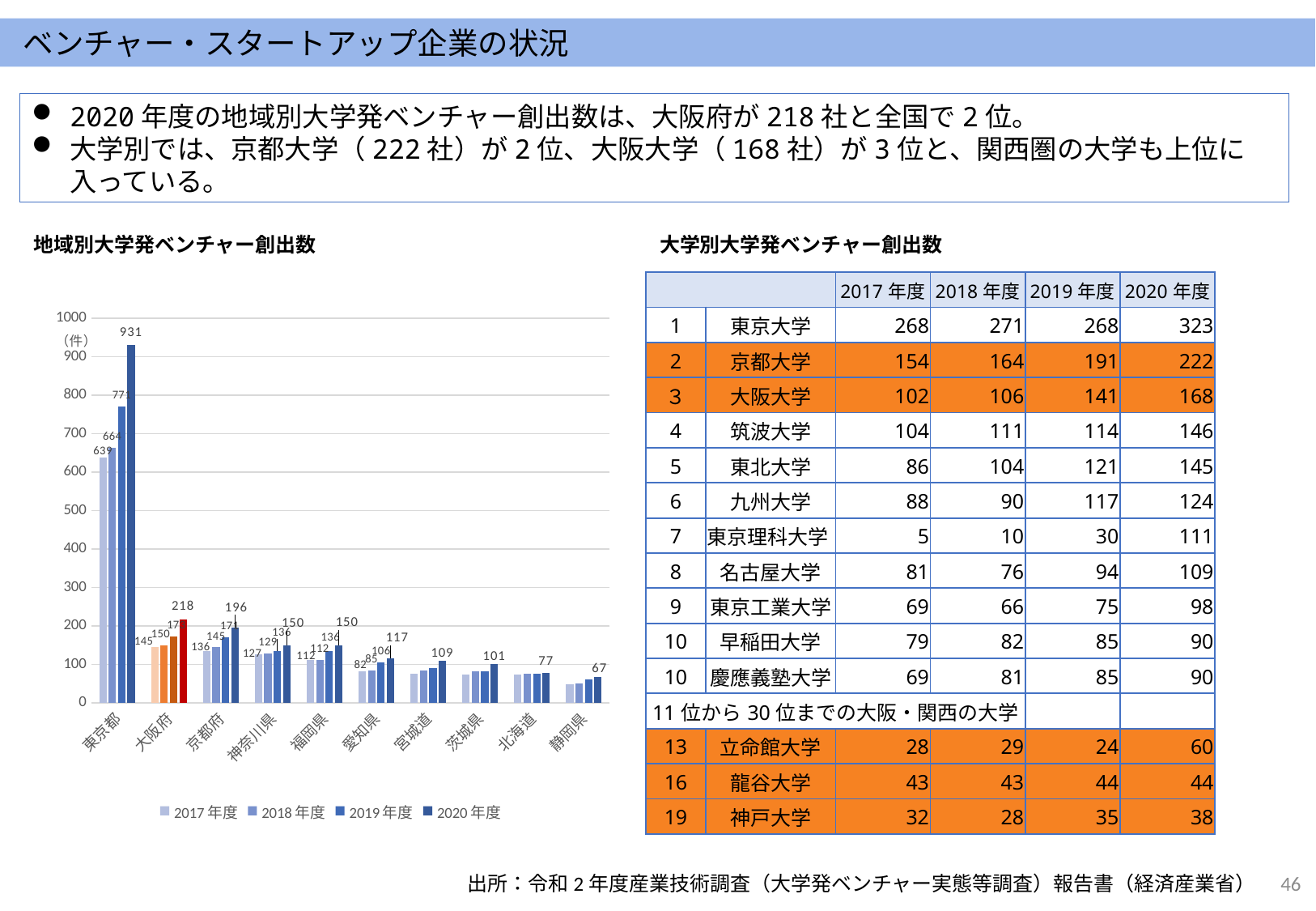
Do the values for 東京都 rise or fall from 2017年度 to 2020年度? rise What kind of chart is shown on the slide? bar chart How many prefectures/regions are shown on the x axis of the chart? 10 Which region has the highest 2020年度 value in the chart? 東京都 What is the 2020年度 value for 東京都 in the chart? 931 Which has the larger 2020年度 value, 大阪府 or 京都府? 大阪府 Which region has the lowest 2020年度 value in the chart? 静岡県 Is the 2017年度 value for 宮城県 greater or less than 100? less What is the 2017年度 value for 神奈川県 in the chart? 127 How many series does the chart legend list? 4 What is the difference between the 2020年度 and 2019年度 values for 東京都? 160 What is the 2020年度 value for 大阪府 in the chart? 218